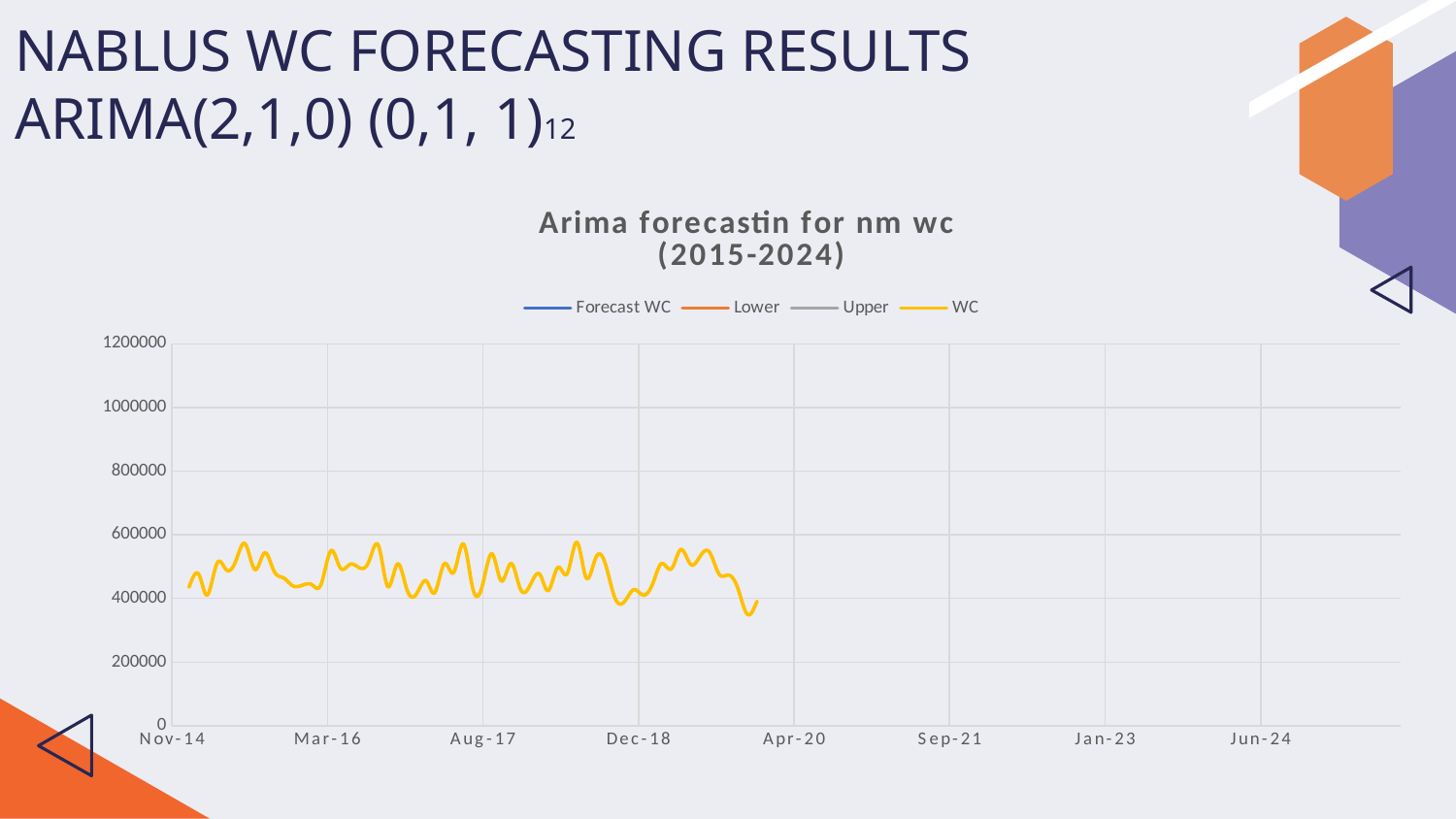
What is the first date label on the x axis? Nov-14 What is the last date label on the x axis? Jun-24 Are the plotted WC values greater or less than 800000? less What is the interval between consecutive y-axis tick labels? 200000 What is the title of the chart? Arima forecastin for nm wc (2015-2024) Are the plotted WC values greater or less than 200000? greater How many series does the chart legend list? 4 What is the highest value shown on the y axis? 1200000 What kind of chart is shown on the slide? Line chart Does the plotted WC line extend beyond the Apr-20 tick on the x axis? No Which series are listed in the chart legend? Forecast WC, Lower, Upper, WC How many date labels are shown on the x axis? 8